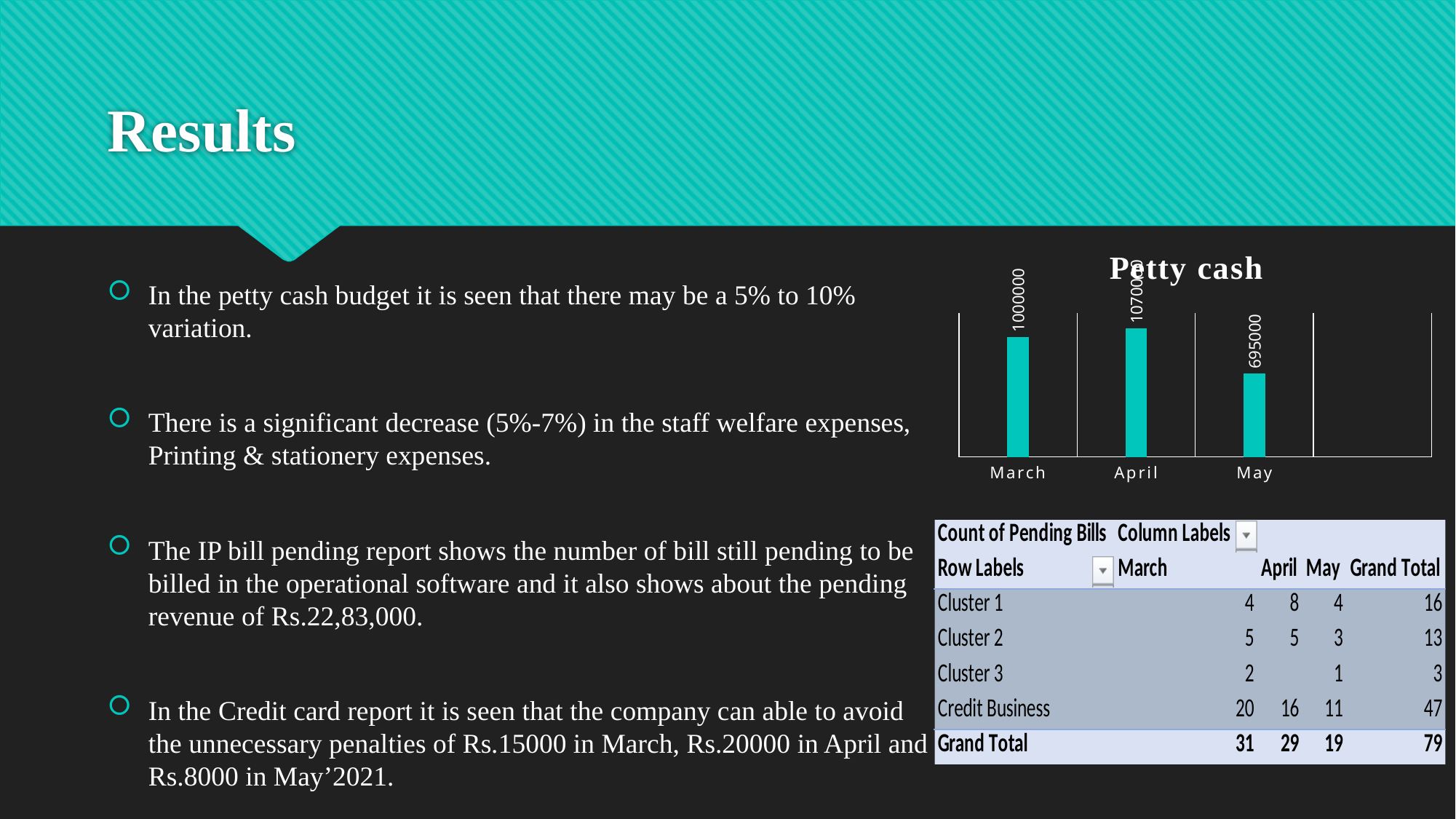
What is the petty cash value for May? 695000 What is the title of the chart on the slide? Petty cash What is the difference between the petty cash values for March and May? 305000 Which month has a larger petty cash value, March or May? March What colour are the bars in the Petty cash chart? Teal Which month has the lowest petty cash value? May What is the petty cash value for March? 1000000 How many months are shown in the Petty cash chart? 3 Does the petty cash value rise or fall from April to May? Fall Which month has the highest petty cash value? April What kind of chart is the Petty cash chart? Bar chart